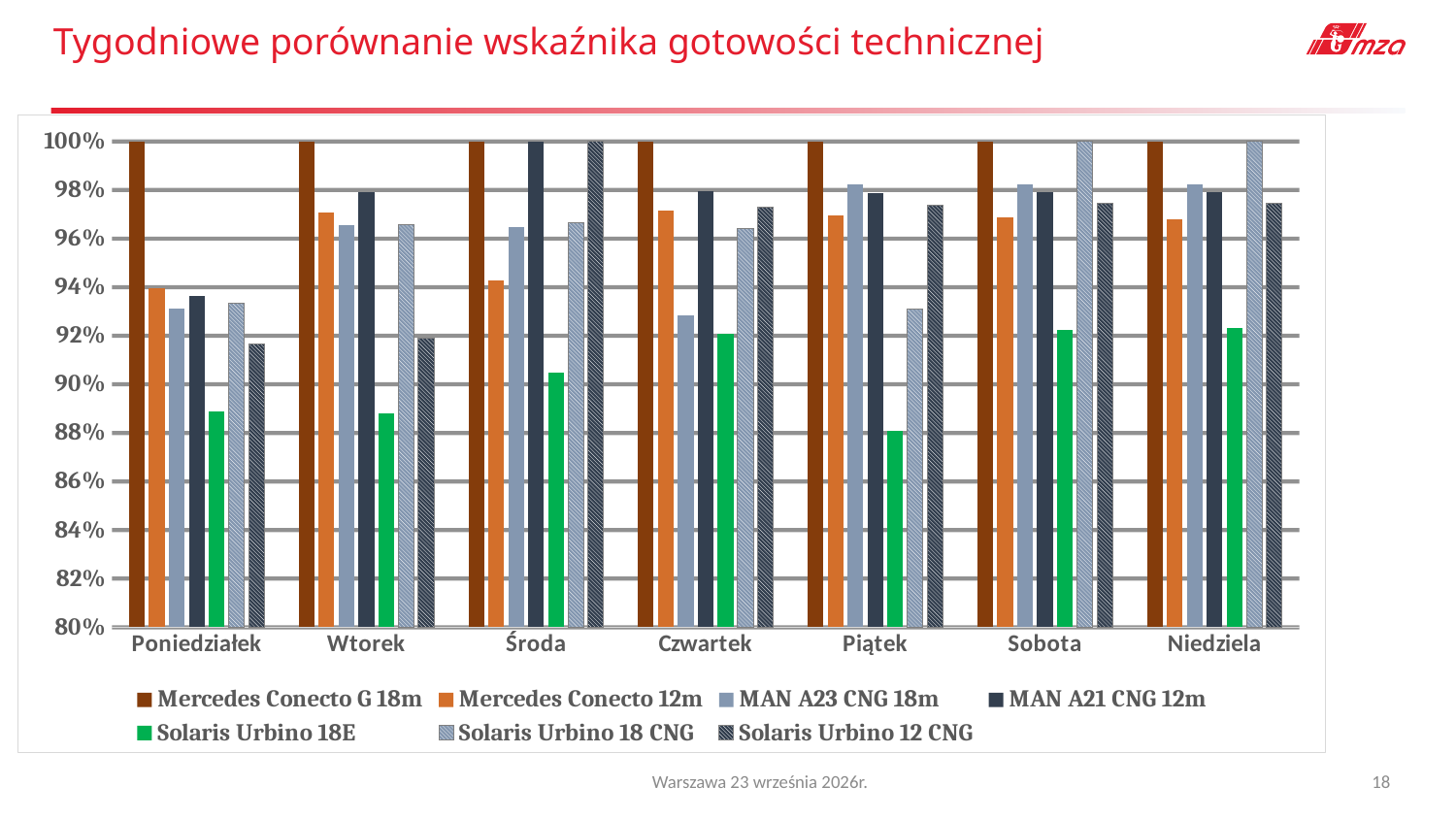
What is the value for Solaris Urbino 18 CNG on Sobota? 100% Which series has the highest value on Piątek? Mercedes Conecto G 18m What kind of chart is shown on the slide? bar chart Which series has the lowest value on Poniedziałek? Solaris Urbino 18E On Wtorek, which is larger: Mercedes Conecto 12m or Solaris Urbino 18E? Mercedes Conecto 12m Is the value for MAN A23 CNG 18m on Poniedziałek greater or less than 92%? greater How many days (categories) are shown on the x axis? 7 Is the value for Mercedes Conecto 12m on Środa greater or less than 96%? less What is the value for Mercedes Conecto G 18m on Poniedziałek? 100% Is the value for Solaris Urbino 18E on Poniedziałek greater or less than 90%? less How many series does the legend list? 7 What is the title of the chart on the slide? Tygodniowe porównanie wskaźnika gotowości technicznej